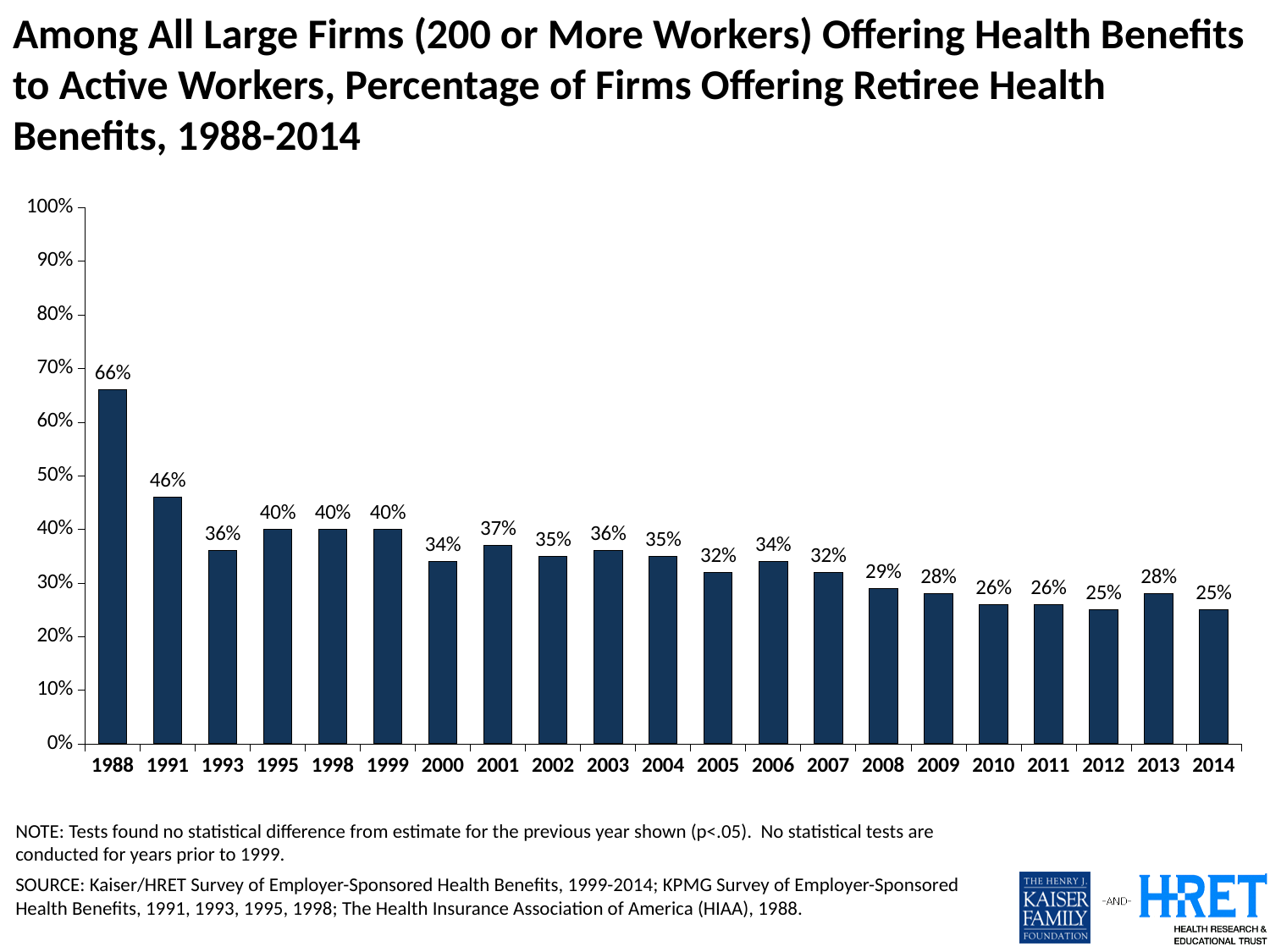
Do the values generally rise or fall from 1988 to 2014? Fall What is the lowest percentage shown on the chart? 25% What percentage of large firms offered retiree health benefits in 1988? 66% Which year has the larger value, 2001 or 2005? 2001 What kind of chart is shown on the slide? Bar chart How many years are shown on the x axis? 21 What is the difference in percentage points between the 1988 value and the 2014 value? 41 percentage points What percentage is shown for 2008? 29% What is the value shown for 2014? 25% Which year has the highest percentage of firms offering retiree health benefits? 1988 By how many percentage points did the value fall from 1991 to 1993? 10 percentage points Is the value for 1988 greater or less than 60%? greater